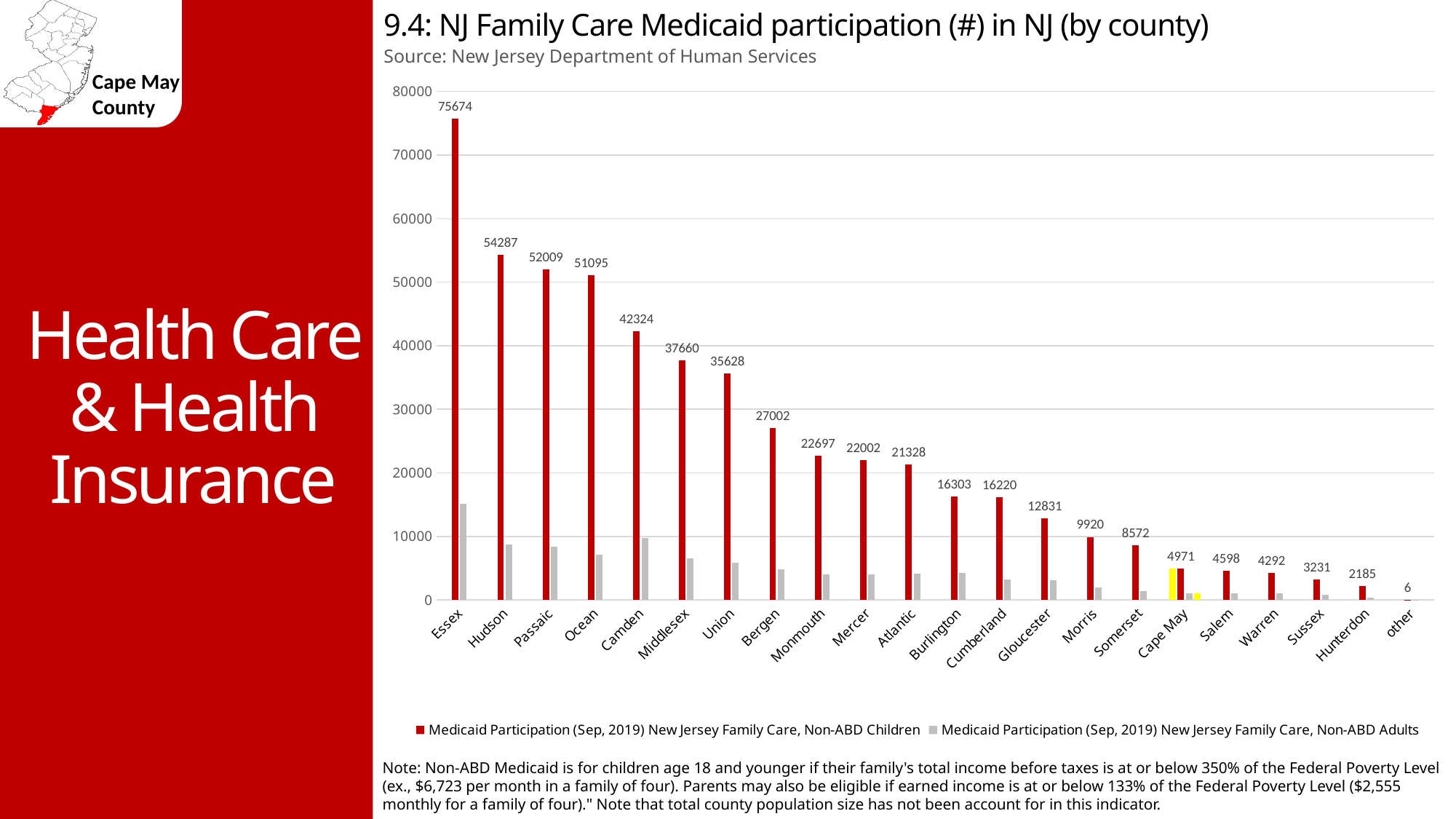
Do the Non-ABD Children values rise or fall from Essex to Hunterdon along the x axis? fall What is the difference between the Non-ABD Children values for Hudson and Passaic? 2278 What is the Non-ABD Children Medicaid participation value for Essex? 75674 Which has a larger Non-ABD Children value, Burlington or Cumberland? Burlington Is the Non-ABD Adults value for Essex greater or less than 10000? greater How many categories are shown on the x axis? 22 What kind of chart is shown on the slide? bar chart Which category has the highest Non-ABD Children Medicaid participation? Essex Which category has the lowest Non-ABD Children Medicaid participation? other What is the Non-ABD Children Medicaid participation value for Cape May? 4971 How many series does the legend list? 2